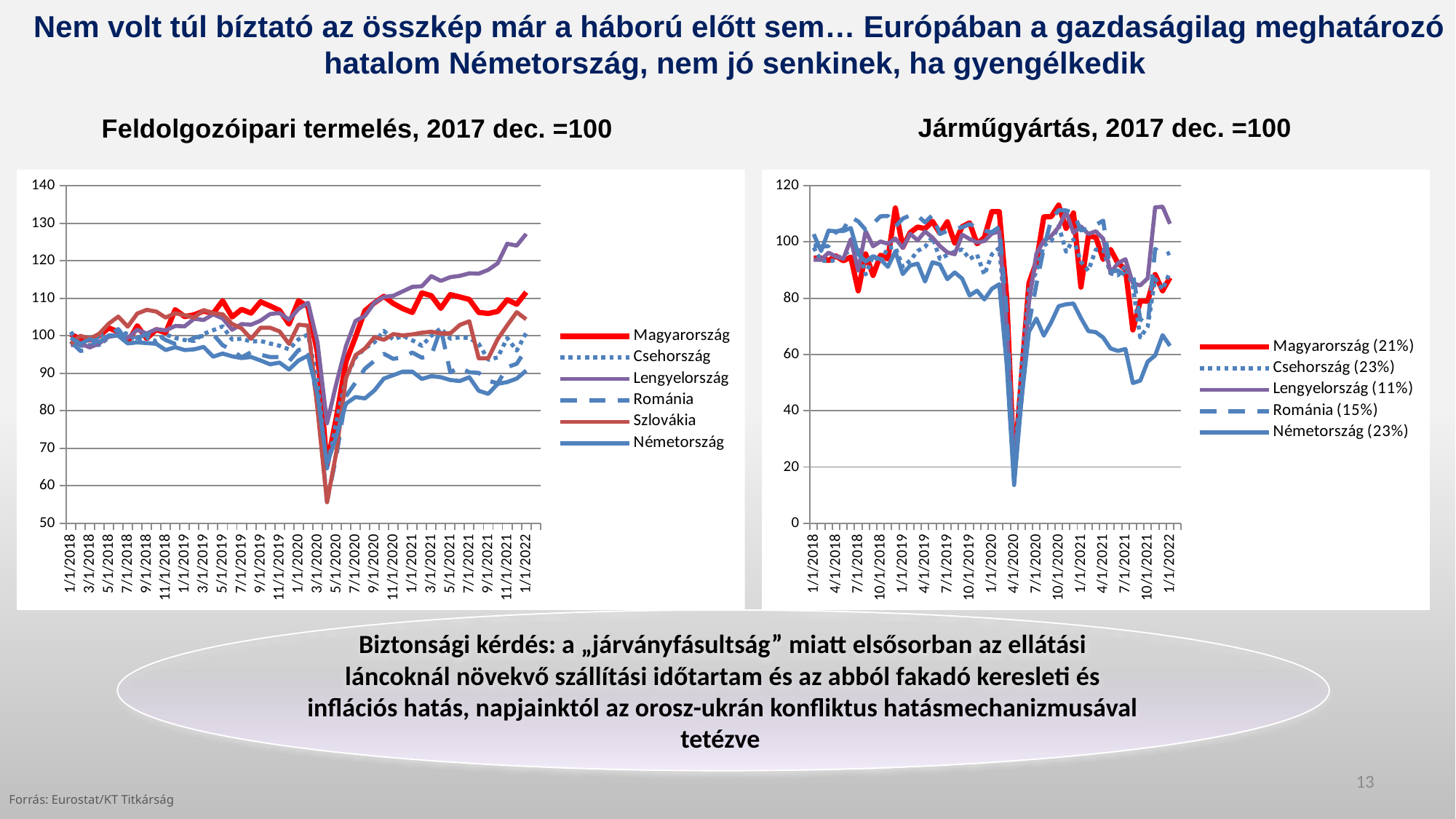
In the 'Járműgyártás, 2017 dec. =100' chart, is the value for Németország at 1/1/2022 greater or less than 80? less How many series does the legend of the 'Feldolgozóipari termelés, 2017 dec. =100' chart list? 6 In the 'Járműgyártás, 2017 dec. =100' chart, which series is lowest at 1/1/2022? Németország (23%) In the 'Feldolgozóipari termelés, 2017 dec. =100' chart, is the value for Németország at 1/1/2022 greater or less than 100? less In the 'Járműgyártás, 2017 dec. =100' chart, is the lowest point of the Németország line in 2020 greater or less than 20? less In the 'Feldolgozóipari termelés, 2017 dec. =100' chart, which series is highest at 1/1/2022? Lengyelország How many series does the legend of the 'Járműgyártás, 2017 dec. =100' chart list? 5 In the 'Járműgyártás, 2017 dec. =100' chart, which is larger at 1/1/2022: Lengyelország or Németország? Lengyelország What kind of chart is the 'Feldolgozóipari termelés, 2017 dec. =100' chart? line chart What percentage is shown next to Magyarország in the legend of the 'Járműgyártás, 2017 dec. =100' chart? 21% In the 'Feldolgozóipari termelés, 2017 dec. =100' chart, which series is lowest at 1/1/2022? Németország